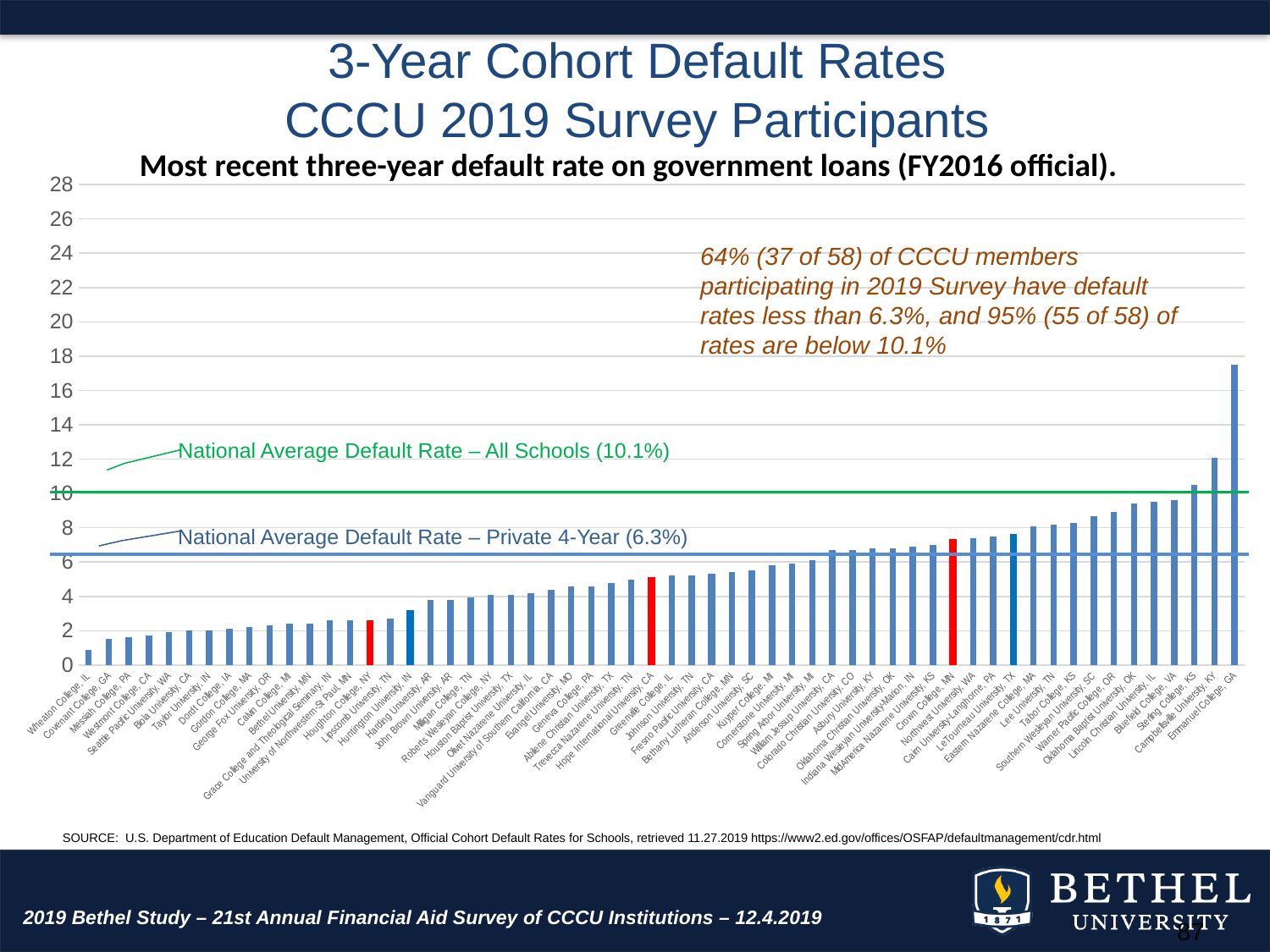
Which has the larger default rate, Emmanuel College, GA or Wheaton College, IL? Emmanuel College, GA Is the default rate for Wheaton College, IL greater or less than 2? less What is the National Average Default Rate for Private 4-Year schools shown on the chart? 6.3% Which school has the lowest three-year default rate on the chart? Wheaton College, IL According to the annotation on the chart, how many CCCU members participated in the 2019 Survey? 58 Is the default rate for Campbellsville University, KY greater or less than 10? greater Is the default rate for Bethel University, MN greater or less than 4? less What is the National Average Default Rate for All Schools shown on the chart? 10.1% What kind of chart is shown on the slide? bar chart Do the default rates rise or fall moving from left to right along the x axis? rise Which school has the highest three-year default rate on the chart? Emmanuel College, GA